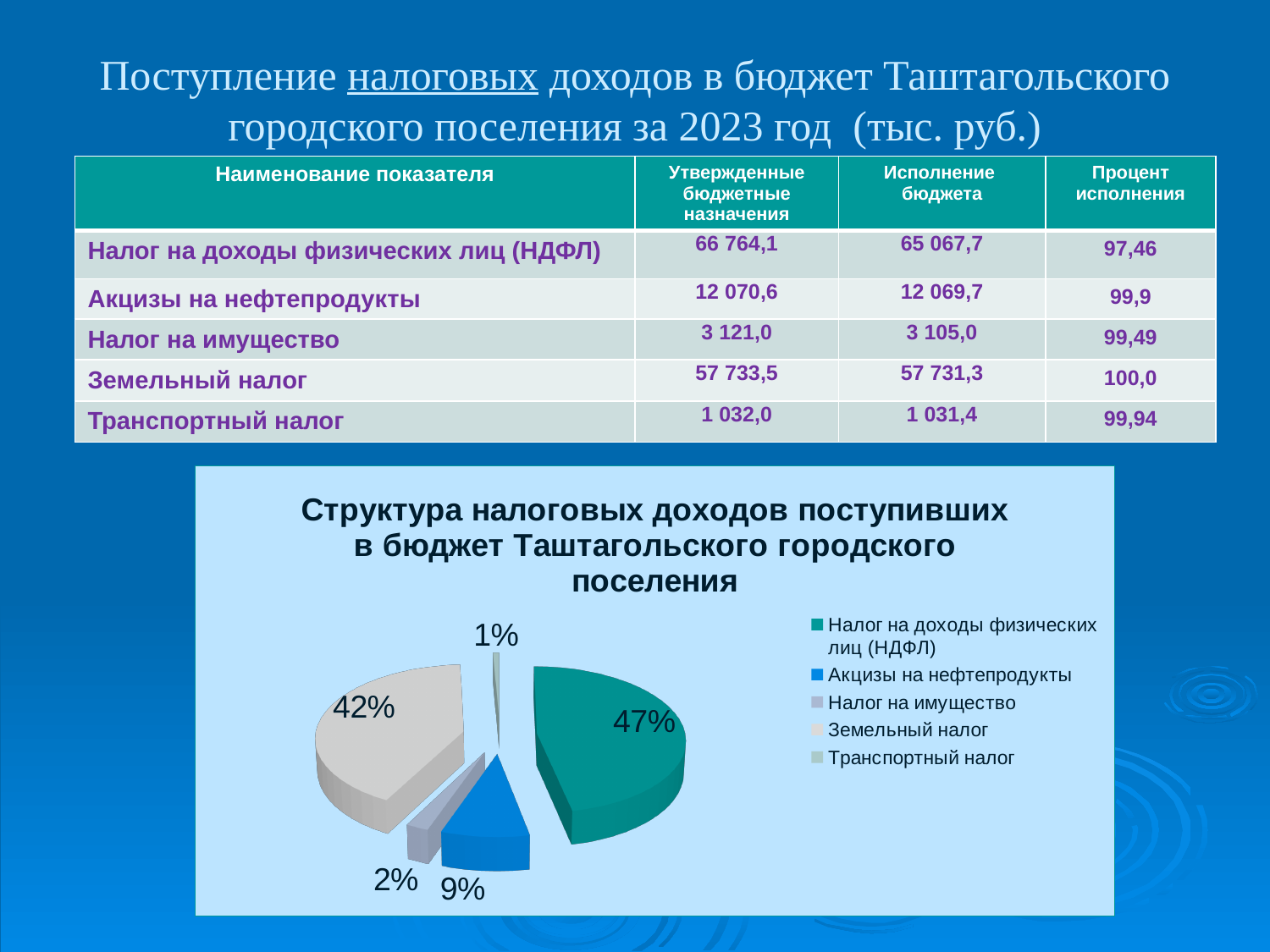
What share of the pie does Налог на имущество have? 2% What share of the pie does Акцизы на нефтепродукты have? 9% Which is larger: the slice for Акцизы на нефтепродукты or the slice for Налог на имущество? Акцизы на нефтепродукты What kind of chart is shown on the slide? Pie chart What share of the pie does Земельный налог have? 42% Which category has the largest slice of the pie? Налог на доходы физических лиц (НДФЛ) Which category has the smallest slice of the pie? Транспортный налог What is the title of the chart? Структура налоговых доходов поступивших в бюджет Таштагольского городского поселения What is the difference in percentage points between the НДФЛ slice and the Земельный налог slice? 5 How many categories does the pie chart legend list? 5